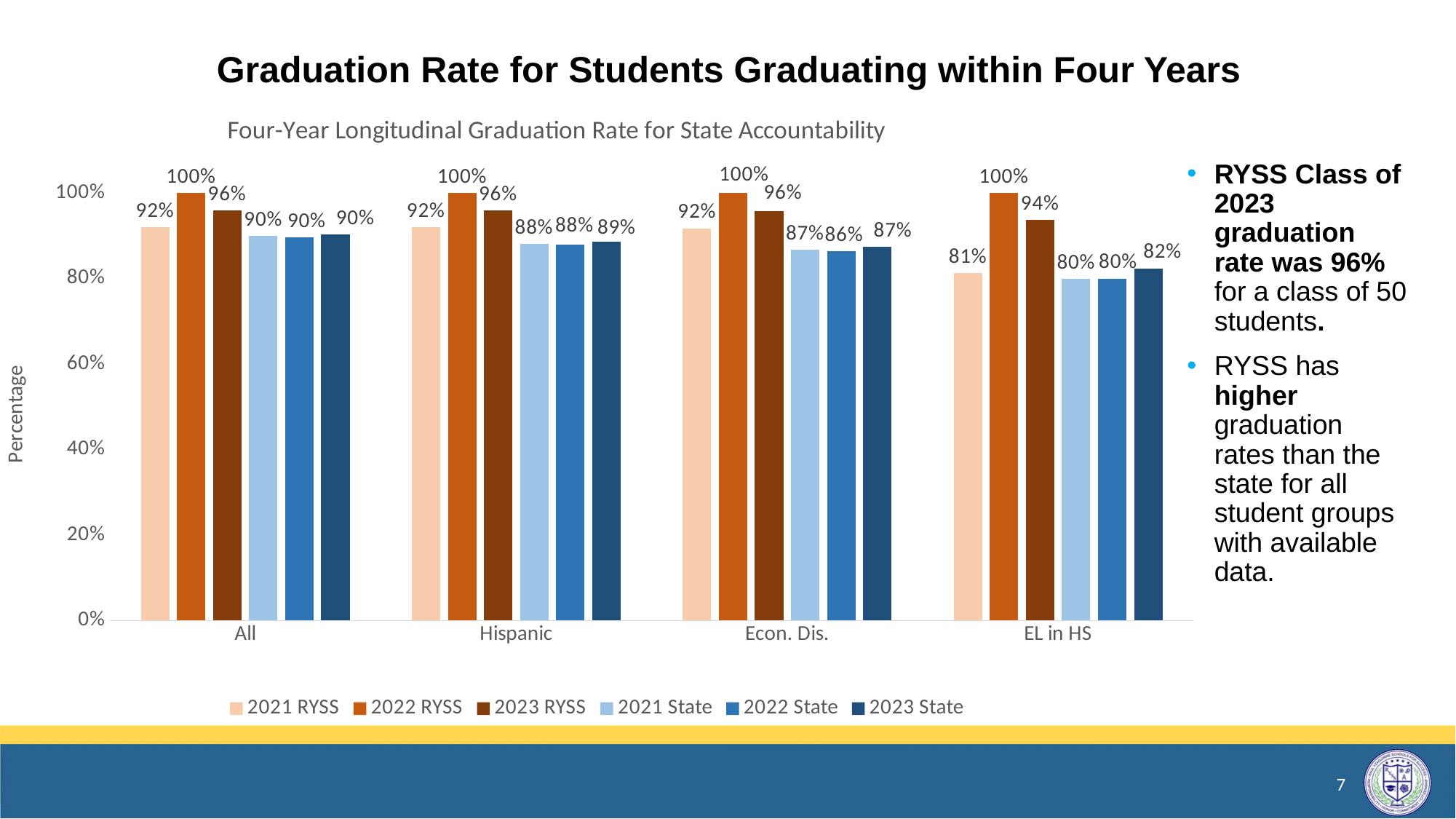
What is the 2023 RYSS graduation rate for the All category? 96% What is the 2022 State graduation rate for Hispanic students? 88% What is the title shown above the chart's plot area? Four-Year Longitudinal Graduation Rate for State Accountability What is the 2021 RYSS graduation rate for EL in HS? 81% What is the difference between the 2022 RYSS and 2021 RYSS graduation rates for the All category? 8% How many categories are shown on the x axis? 4 Which is larger for Econ. Dis.: the 2023 RYSS rate or the 2023 State rate? 2023 RYSS Which category has the lowest 2023 RYSS graduation rate? EL in HS What kind of chart is shown on the slide? Bar chart How many series does the legend list? 6 What is the 2023 State graduation rate for Econ. Dis.? 87% What is the difference between the 2023 RYSS and 2023 State graduation rates for EL in HS? 12%